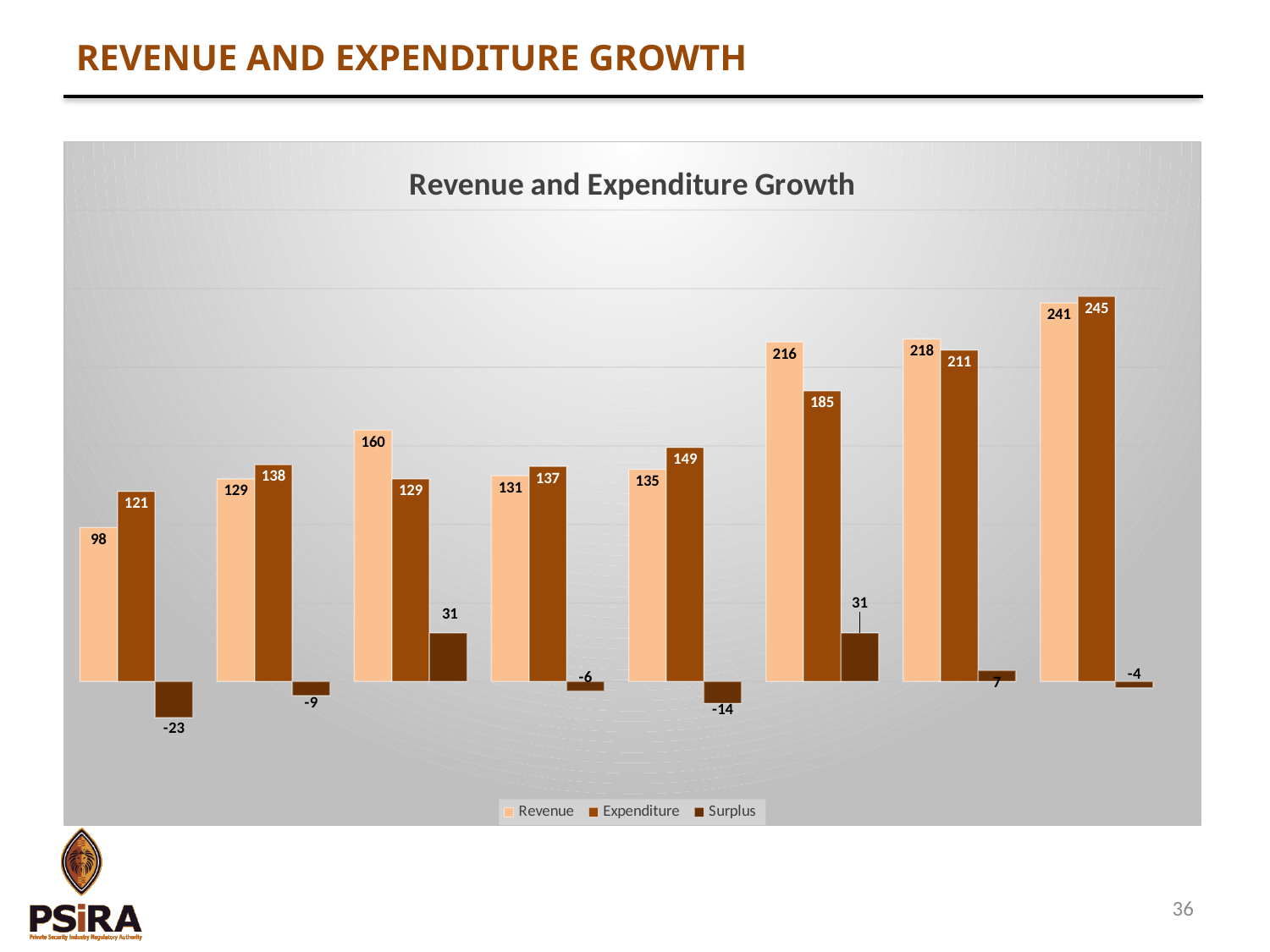
What is the lowest Revenue value shown in the chart? 98 What is the Revenue value in the leftmost group of bars? 98 Do the Revenue values generally rise or fall from left to right across the chart? rise What is the highest Expenditure value shown in the chart? 245 What kind of chart is shown on the slide? bar chart In the rightmost group of bars, which is larger, Revenue or Expenditure? Expenditure What is the lowest Surplus value shown in the chart? -23 What is the highest Revenue value shown in the chart? 241 How many series does the legend list? 3 What is the title of the chart? Revenue and Expenditure Growth In the leftmost group of bars, what is the difference between Expenditure and Revenue? 23 How many groups of bars are plotted in the chart? 8